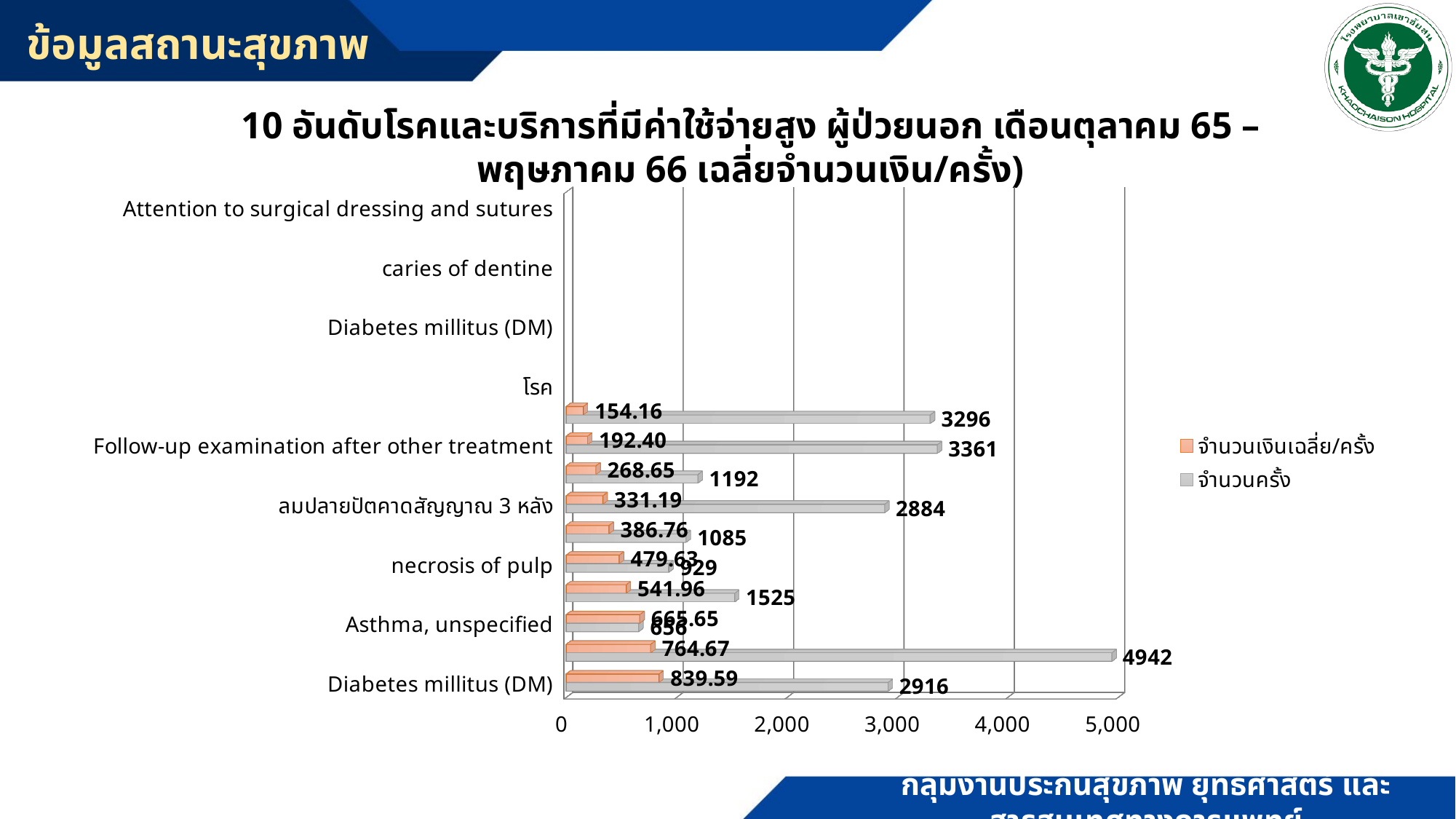
What is the smallest value shown for the จำนวนเงินเฉลี่ย/ครั้ง (orange) series? 154.16 What is the difference between the largest gray bar value (4942) and the bottom-most gray bar value (2916)? 2026 What is the smallest value shown for the จำนวนครั้ง (gray) series? 656 What are the two legend entries of the chart? จำนวนเงินเฉลี่ย/ครั้ง and จำนวนครั้ง Is the longest จำนวนครั้ง (gray) bar greater or less than 4,000? greater What kind of chart is shown on the slide? bar chart Which is larger, the bottom-most gray bar (2916) or the gray bar directly above it (4942)? 4942 What is the largest value shown for the จำนวนเงินเฉลี่ย/ครั้ง (orange) series? 839.59 What is the value of the bottom-most gray (จำนวนครั้ง) bar in the chart? 2916 How many orange (จำนวนเงินเฉลี่ย/ครั้ง) bars are plotted in the chart? 10 How many series does the legend list? 2 What is the largest value shown for the จำนวนครั้ง (gray) series? 4942